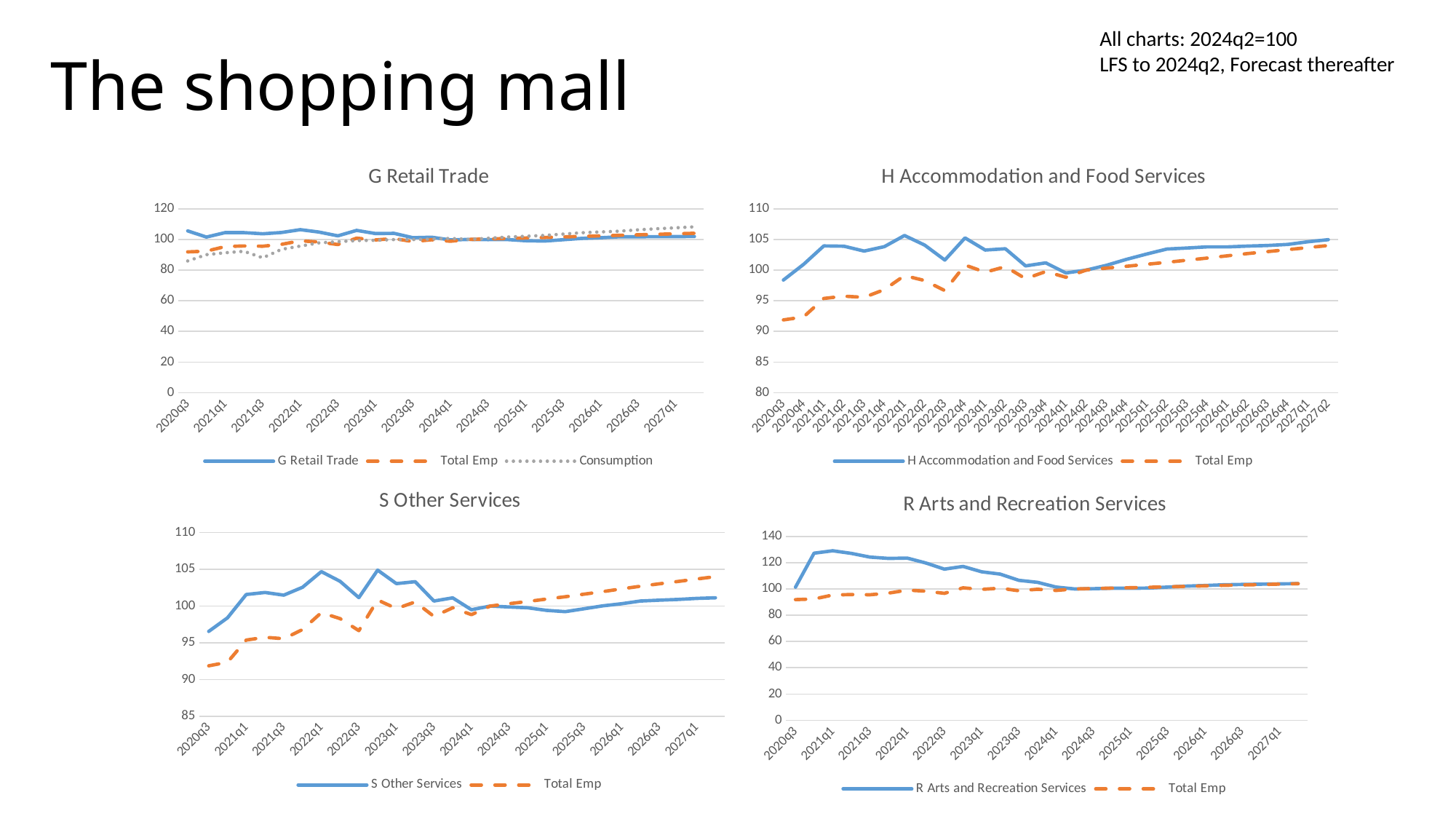
How many series does the legend of the 'H Accommodation and Food Services' chart list? 2 In the 'H Accommodation and Food Services' chart, is the value of Total Emp at 2020q3 greater or less than 95? less In the 'R Arts and Recreation Services' chart, at 2021q1, which is larger: the R Arts and Recreation Services line or the Total Emp line? R Arts and Recreation Services In the 'G Retail Trade' chart, which series is drawn with a dotted line? Consumption What is the title of the bottom-left chart on the slide? S Other Services In the 'H Accommodation and Food Services' chart, does the Total Emp line generally rise or fall from 2020q3 to 2027q2? rise What kind of chart is the 'G Retail Trade' chart? line chart How many series does the legend of the 'G Retail Trade' chart list? 3 In the 'G Retail Trade' chart, is the value of Consumption at 2020q3 greater or less than 100? less In the 'R Arts and Recreation Services' chart, is the value of the R Arts and Recreation Services line at 2021q1 greater or less than 120? greater In the 'R Arts and Recreation Services' chart, does the R Arts and Recreation Services line rise or fall from 2021q1 to 2024q1? fall